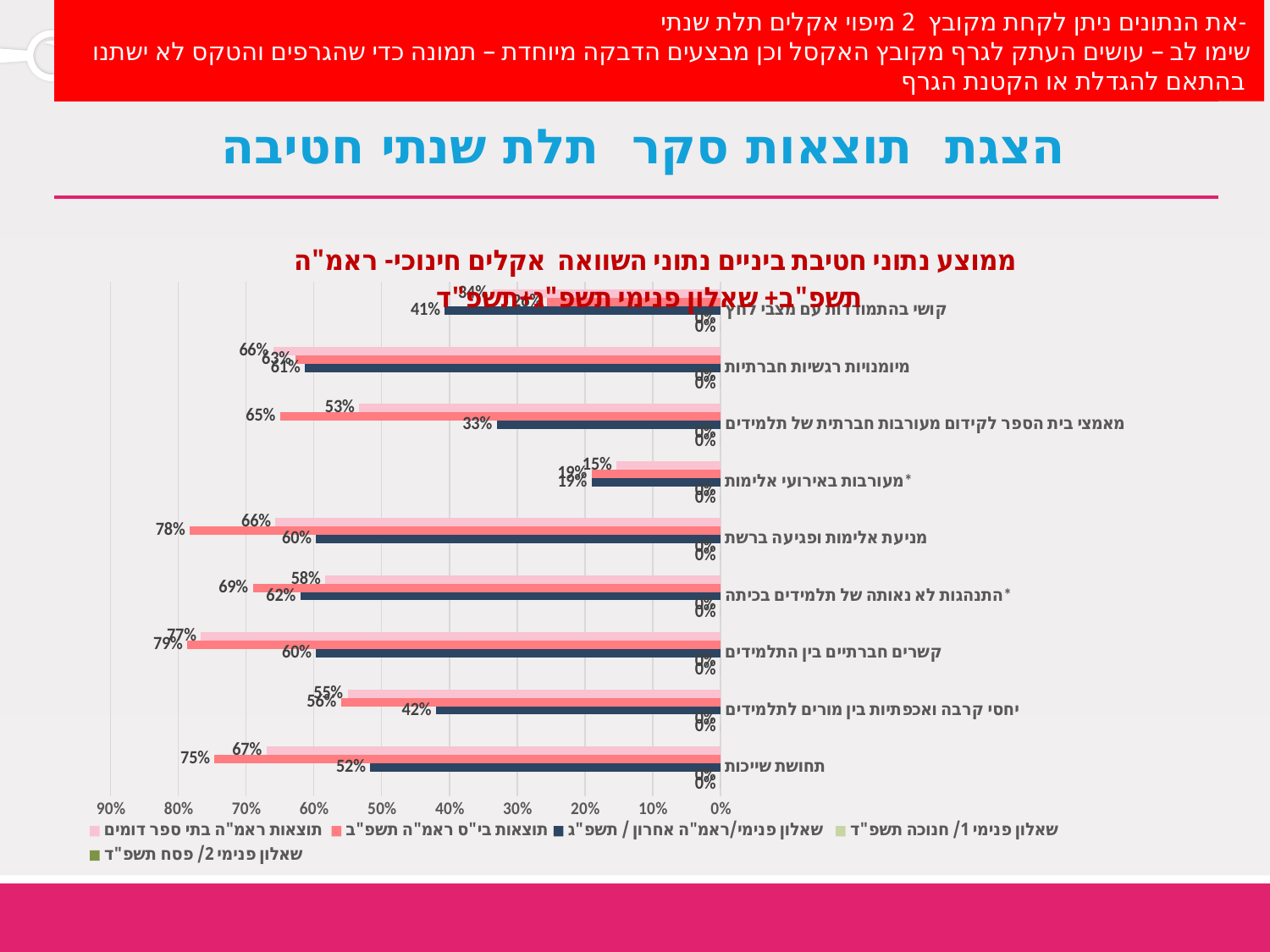
What is the value for יחסי קרבה ואכפתיות בין מורים לתלמידים in the series שאלון פנימי 1/ חנוכה תשפ"ד? 0% What is the highest value shown on the chart's percentage axis? 90% What kind of chart is shown on the slide? bar chart How many categories are plotted on the chart? 9 How many series does the chart legend list? 5